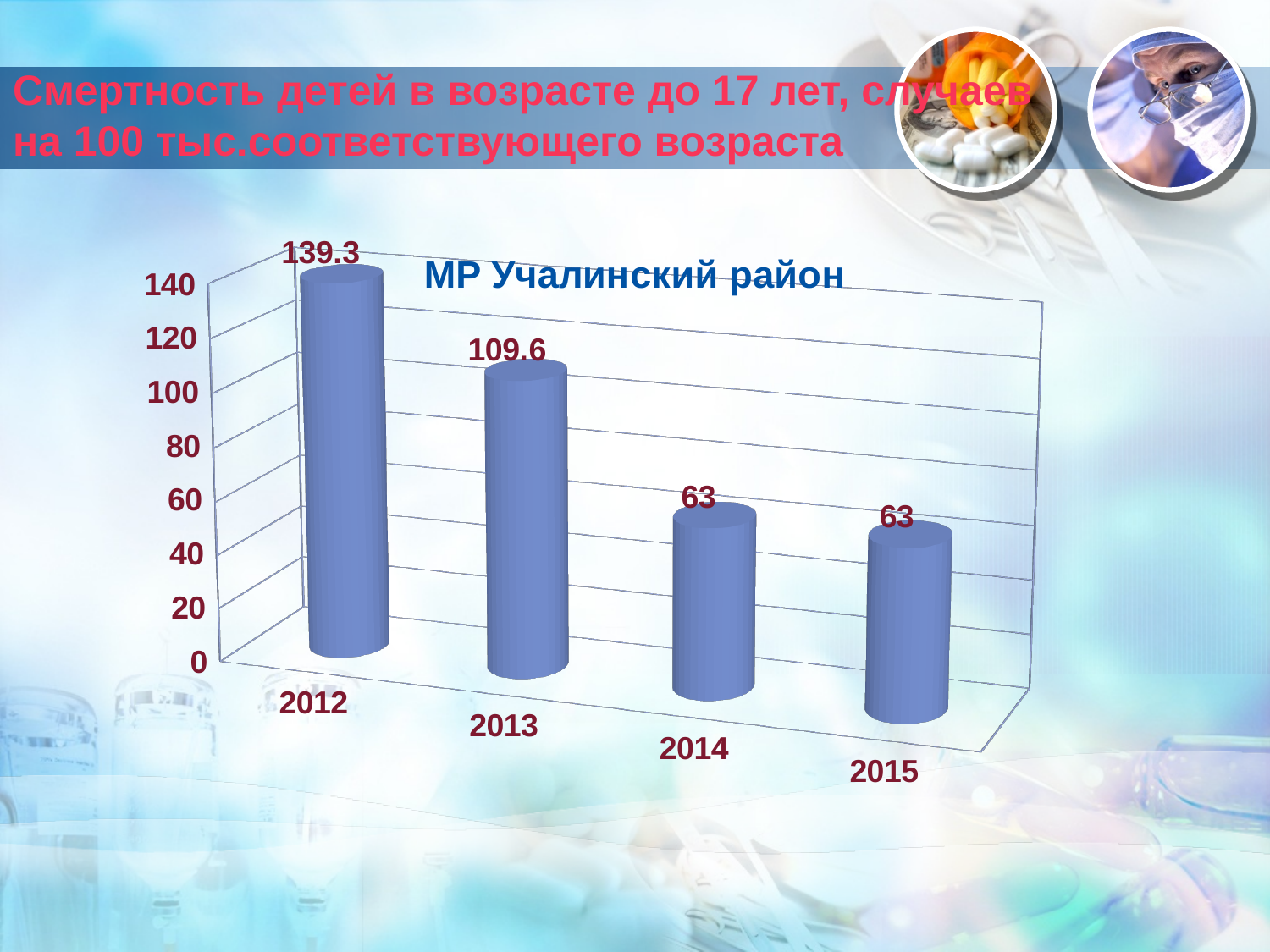
What is the difference between the values for 2012 and 2013? 29.7 What kind of chart is shown on the slide? bar chart Which year has the highest value? 2012 How many years are shown on the chart? 4 What is the value for 2012? 139.3 What is the value for 2013? 109.6 Which is larger, the value for 2012 or the value for 2014? 2012 What is the difference between the values for 2013 and 2014? 46.6 Do the values rise or fall from 2012 to 2014? fall What is the value for 2014? 63 What is the value for 2015? 63 Is the value for 2013 greater or less than 100? greater